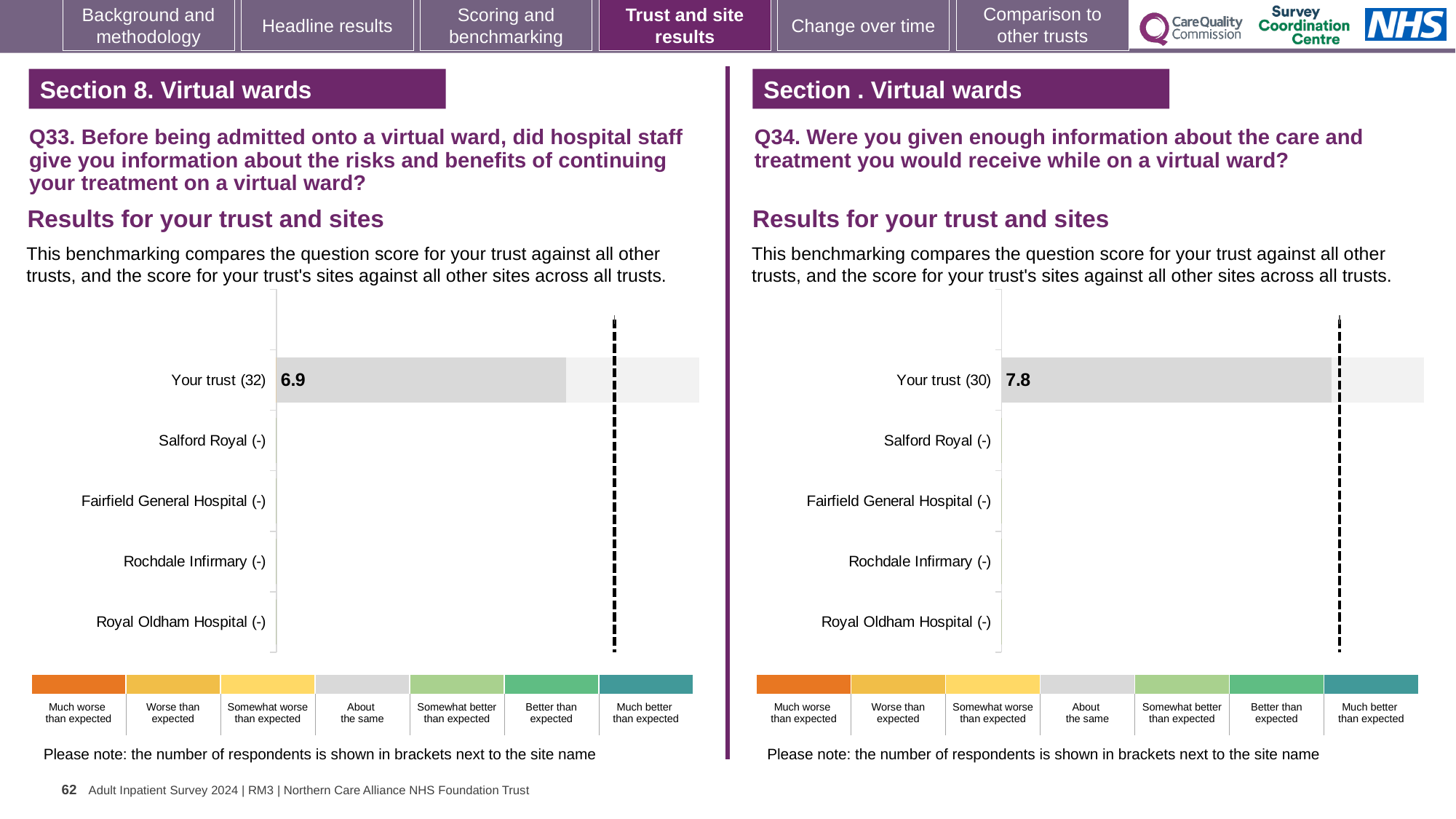
On the Q33 chart (left), how many respondents are shown in brackets next to Your trust? 32 On the Q33 chart (left), what is the score for Your trust? 6.9 On the Q33 chart (left), which category has the highest score shown? Your trust (32) How many categories (trust and sites) are listed on the Q33 chart (left)? 5 Which is larger: the Your trust score on the Q33 chart (left) or the Your trust score on the Q34 chart (right)? Q34 chart (7.8) What kind of chart is used on the Q33 chart (left)? Bar chart On the Q34 chart (right), which category has the highest score shown? Your trust (30) What is the difference between the Your trust score on the Q34 chart (right) and the Your trust score on the Q33 chart (left)? 0.9 On the Q34 chart (right), what is the score for Your trust? 7.8 How many categories (trust and sites) are listed on the Q34 chart (right)? 5 On the Q34 chart (right), how many respondents are shown in brackets next to Your trust? 30